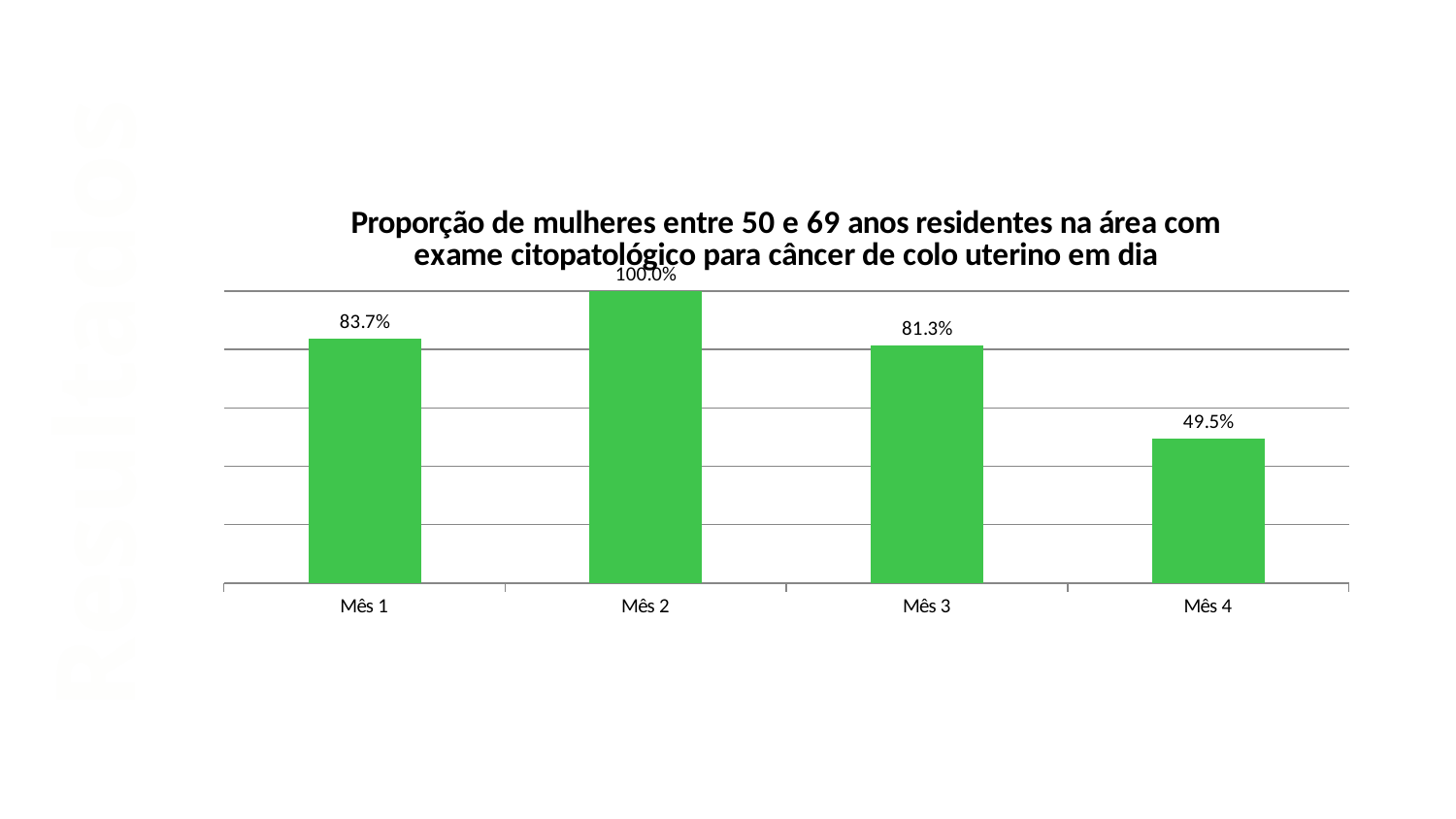
What is the value for Mês 4? 49.5% What kind of chart is shown on the slide? Bar chart What is the value for Mês 1? 83.7% How many months are shown on the x axis? 4 What is the difference between the values for Mês 1 and Mês 3? 2.4% What colour are the bars in the chart? Green What is the value for Mês 3? 81.3% What is the value for Mês 2? 100.0% Which is larger, the value for Mês 3 or the value for Mês 4? Mês 3 Which month has the highest value? Mês 2 Which month has the lowest value? Mês 4 What is the difference between the values for Mês 2 and Mês 4? 50.5%